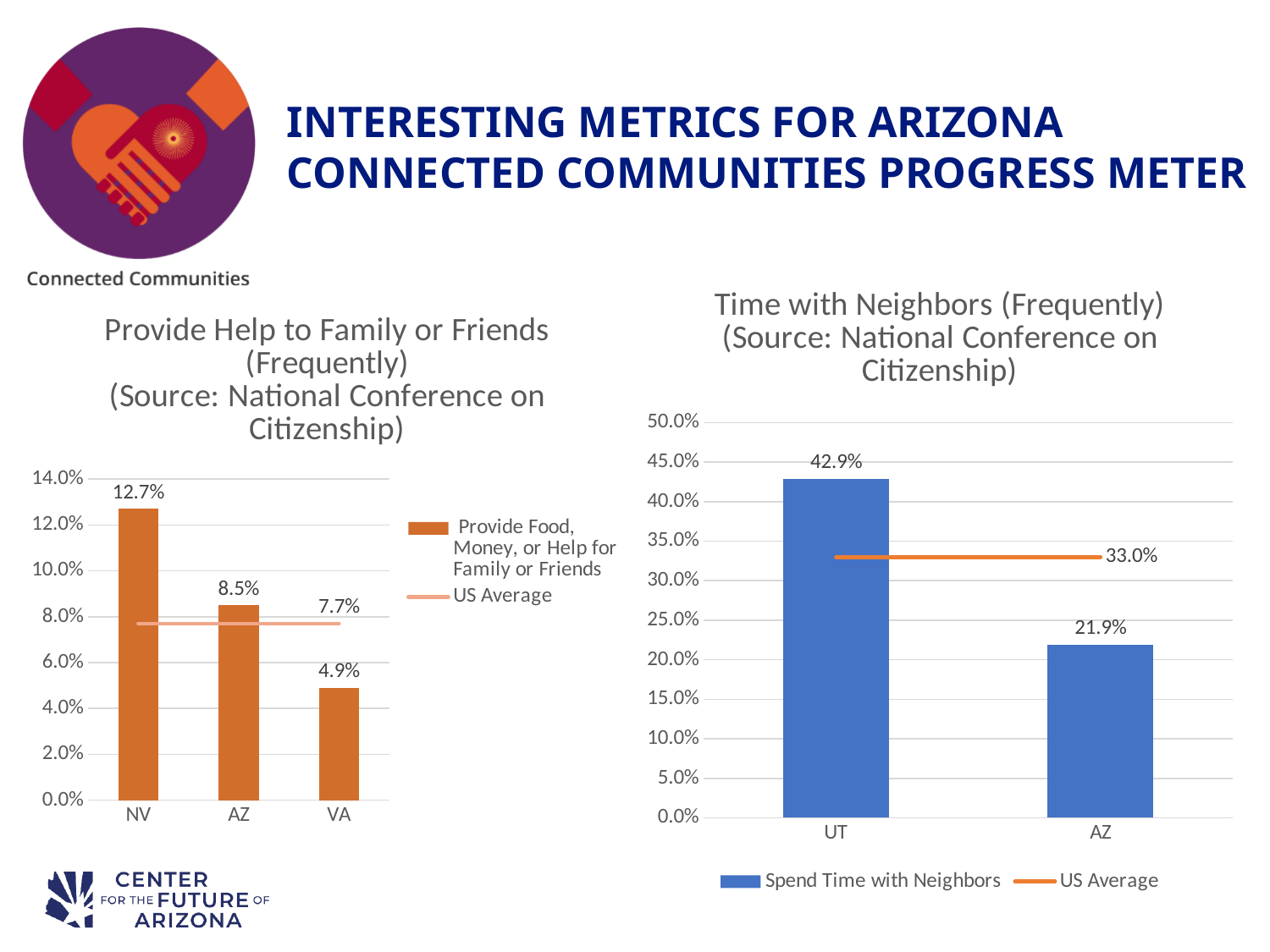
In the 'Provide Help to Family or Friends (Frequently)' chart, what is the difference between NV and VA? 7.8% In the 'Provide Help to Family or Friends (Frequently)' chart, what is the value for NV? 12.7% In the 'Time with Neighbors (Frequently)' chart, what is the value for UT? 42.9% In the 'Time with Neighbors (Frequently)' chart, what is the value for AZ? 21.9% In the 'Provide Help to Family or Friends (Frequently)' chart, what is the value for AZ? 8.5% In the 'Time with Neighbors (Frequently)' chart, what is the difference between UT and AZ? 21.0% In the 'Time with Neighbors (Frequently)' chart, is the value for AZ greater or less than the US Average of 33.0%? less In the 'Provide Help to Family or Friends (Frequently)' chart, which state has the lowest value? VA In the 'Provide Help to Family or Friends (Frequently)' chart, what is the US Average value shown? 7.7% In the 'Provide Help to Family or Friends (Frequently)' chart, how many states are shown on the x axis? 3 What type of chart is the 'Time with Neighbors (Frequently)' chart? Combination bar and line chart In the 'Time with Neighbors (Frequently)' chart, how many entries does the legend list? 2